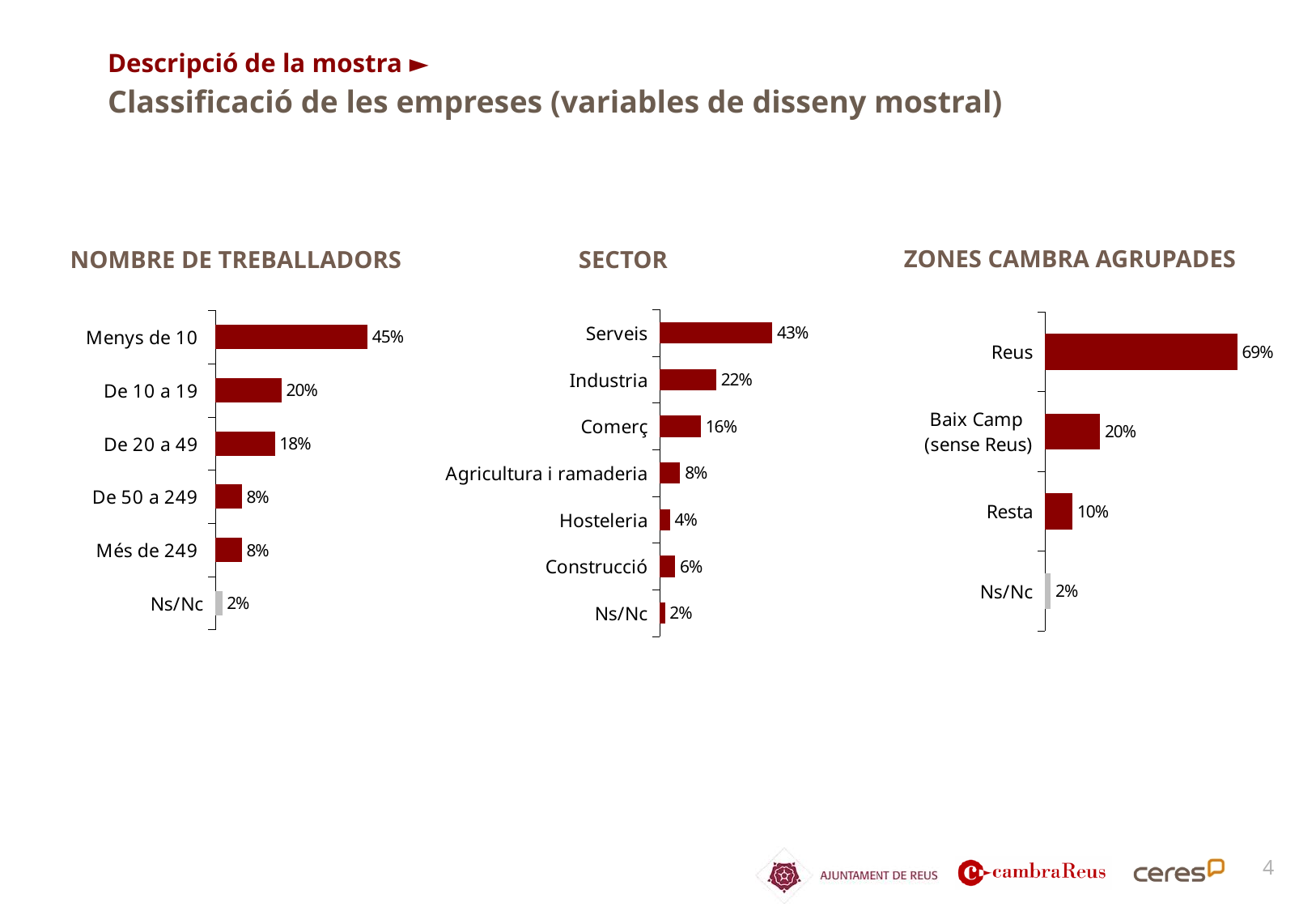
In the NOMBRE DE TREBALLADORS chart, what is the value for Menys de 10? 45% In the NOMBRE DE TREBALLADORS chart, which category has the highest value? Menys de 10 In the NOMBRE DE TREBALLADORS chart, what is the difference between De 10 a 19 and De 20 a 49? 2% In the ZONES CAMBRA AGRUPADES chart, what is the difference between Reus and Baix Camp (sense Reus)? 49% In the SECTOR chart, how many categories are shown? 7 In the SECTOR chart, what is the value for Industria? 22% In the SECTOR chart, which category has the lowest value? Ns/Nc How many charts are shown on the slide? 3 What kind of chart is the SECTOR chart? Bar chart In the NOMBRE DE TREBALLADORS chart, how many categories are shown? 6 In the ZONES CAMBRA AGRUPADES chart, what is the value for Reus? 69% In the SECTOR chart, which is larger, Hosteleria or Construcció? Construcció